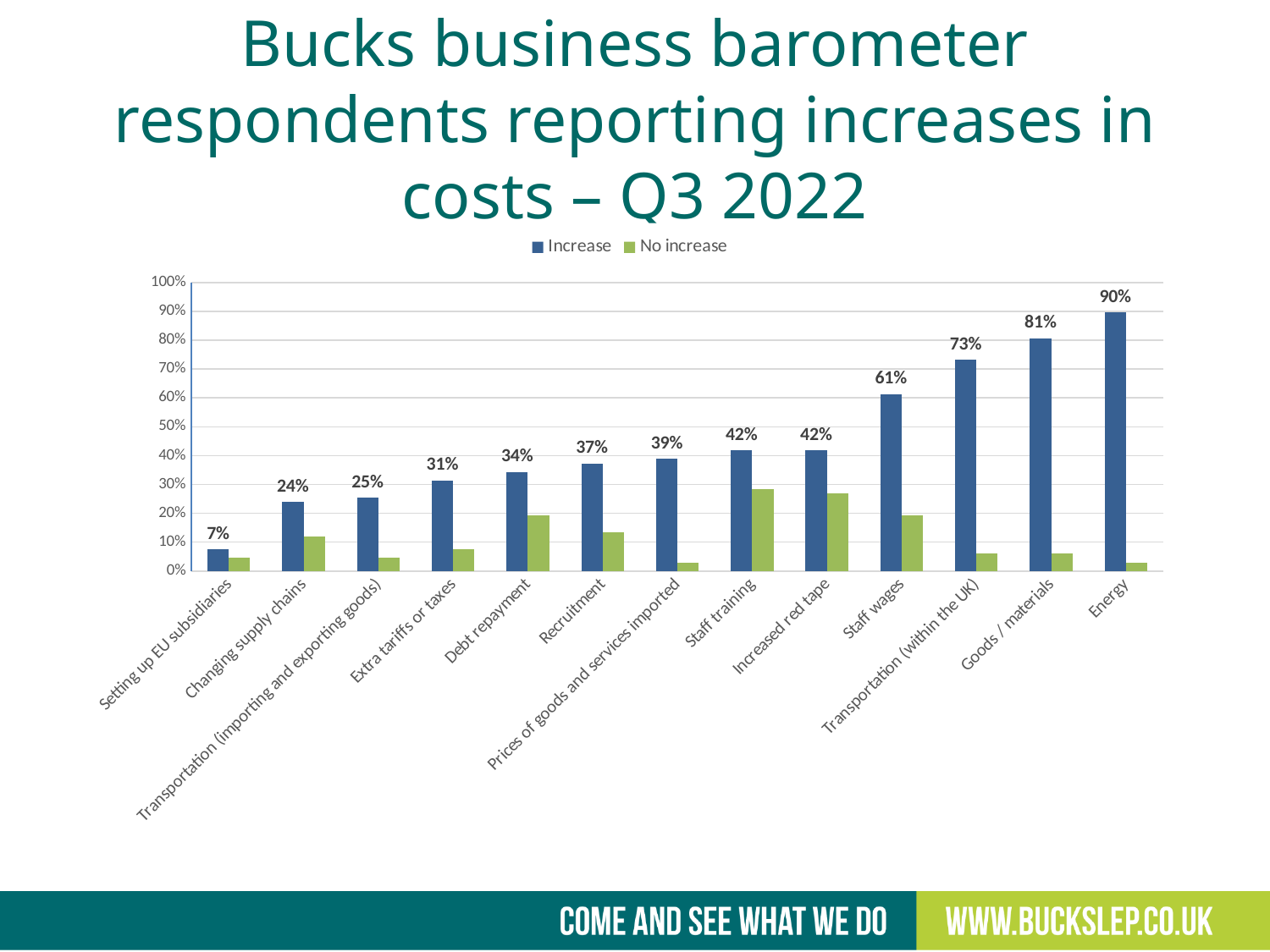
What is the Increase value for Setting up EU subsidiaries? 7% Which category has the lowest Increase value? Setting up EU subsidiaries What kind of chart is shown on the slide? Bar chart Which has a larger Increase value, Recruitment or Debt repayment? Recruitment What percentage of respondents reported an increase in Energy costs? 90% What is the Increase value for Staff wages? 61% Is the No increase value for Staff training greater or less than 20%? greater Which category has the highest Increase value? Energy Is the No increase value for Energy greater or less than 10%? less What is the difference between the Increase values for Goods / materials and Transportation (within the UK)? 8% How many series does the legend list? 2 How many categories are shown on the x axis? 13